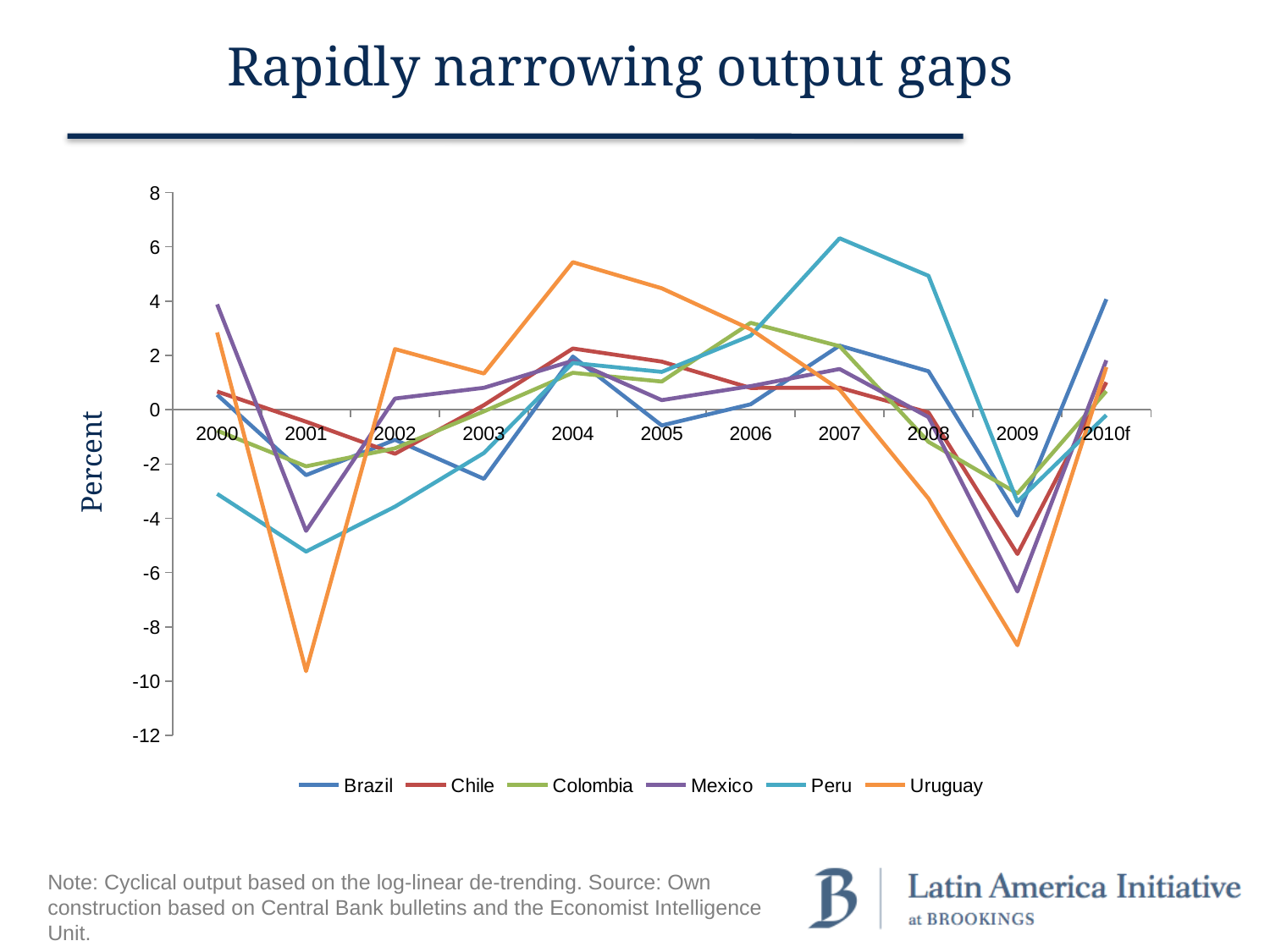
Which country has the highest value in 2007? Peru What is the label on the vertical axis? Percent How many series does the legend list? 6 What kind of chart is shown on the slide? line chart In 2007, which is larger, the value for Peru or the value for Uruguay? Peru Which country has the lowest value in 2009? Uruguay Which country has the highest value in 2010f? Brazil Is the value for Uruguay in 2004 greater or less than 4? greater How many years are shown along the x axis? 11 Is the value for Peru in 2007 greater or less than 6? greater Is the value for Uruguay in 2001 greater or less than -8? less Which country has the lowest value in 2001? Uruguay